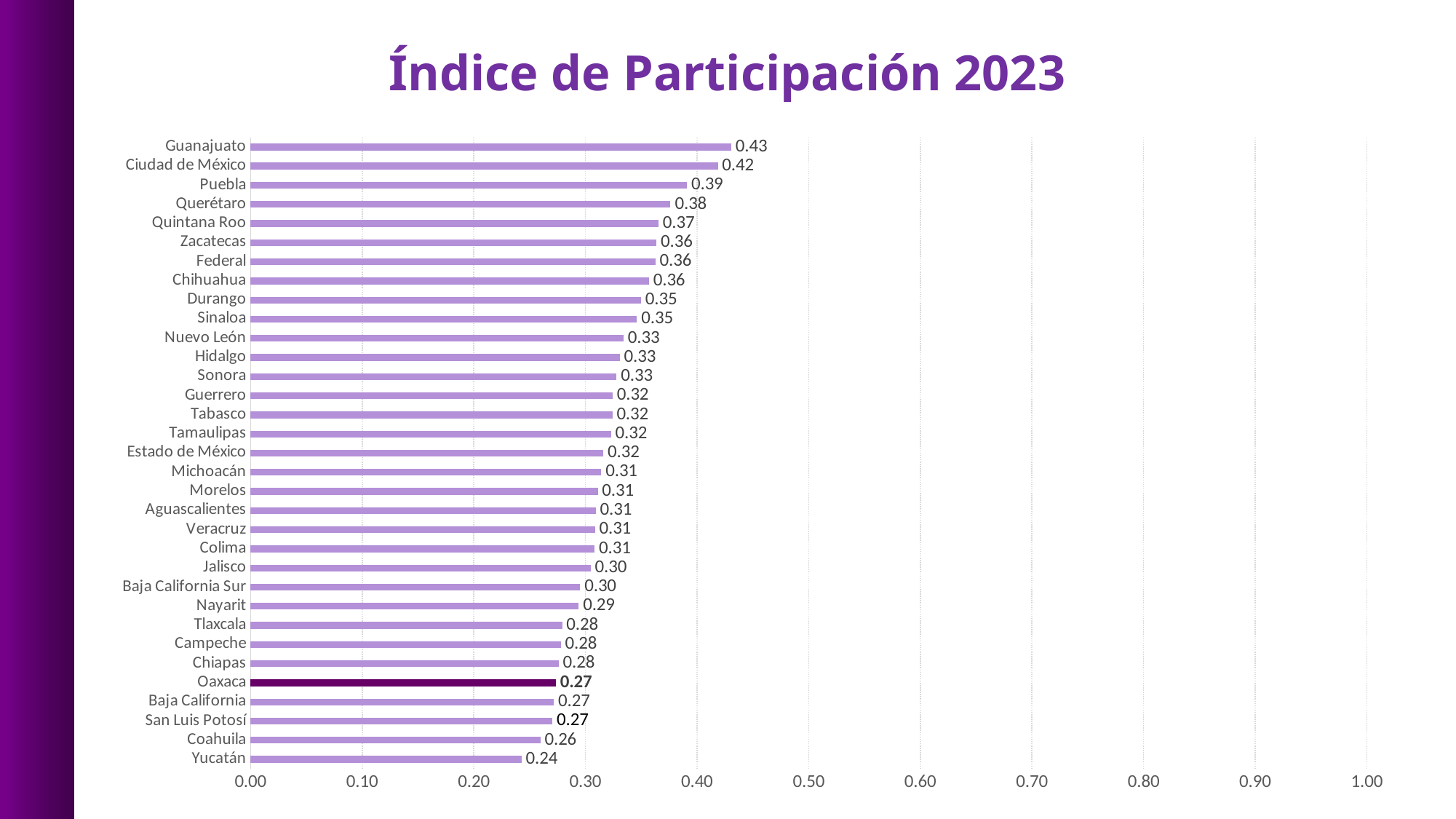
Which category has the lowest value? Yucatán What is the value for Oaxaca? 0.27 What kind of chart is shown on the slide? Bar chart Which is larger, the value for Puebla or the value for Durango? Puebla What is the title of the chart? Índice de Participación 2023 What is the value for Guanajuato? 0.43 Which category has the highest value? Guanajuato What is the difference between the values for Guanajuato and Yucatán? 0.19 What is the value for Yucatán? 0.24 What is the value for Nuevo León? 0.33 Is the value for Ciudad de México greater or less than 0.40? greater How many categories are shown in the chart? 33